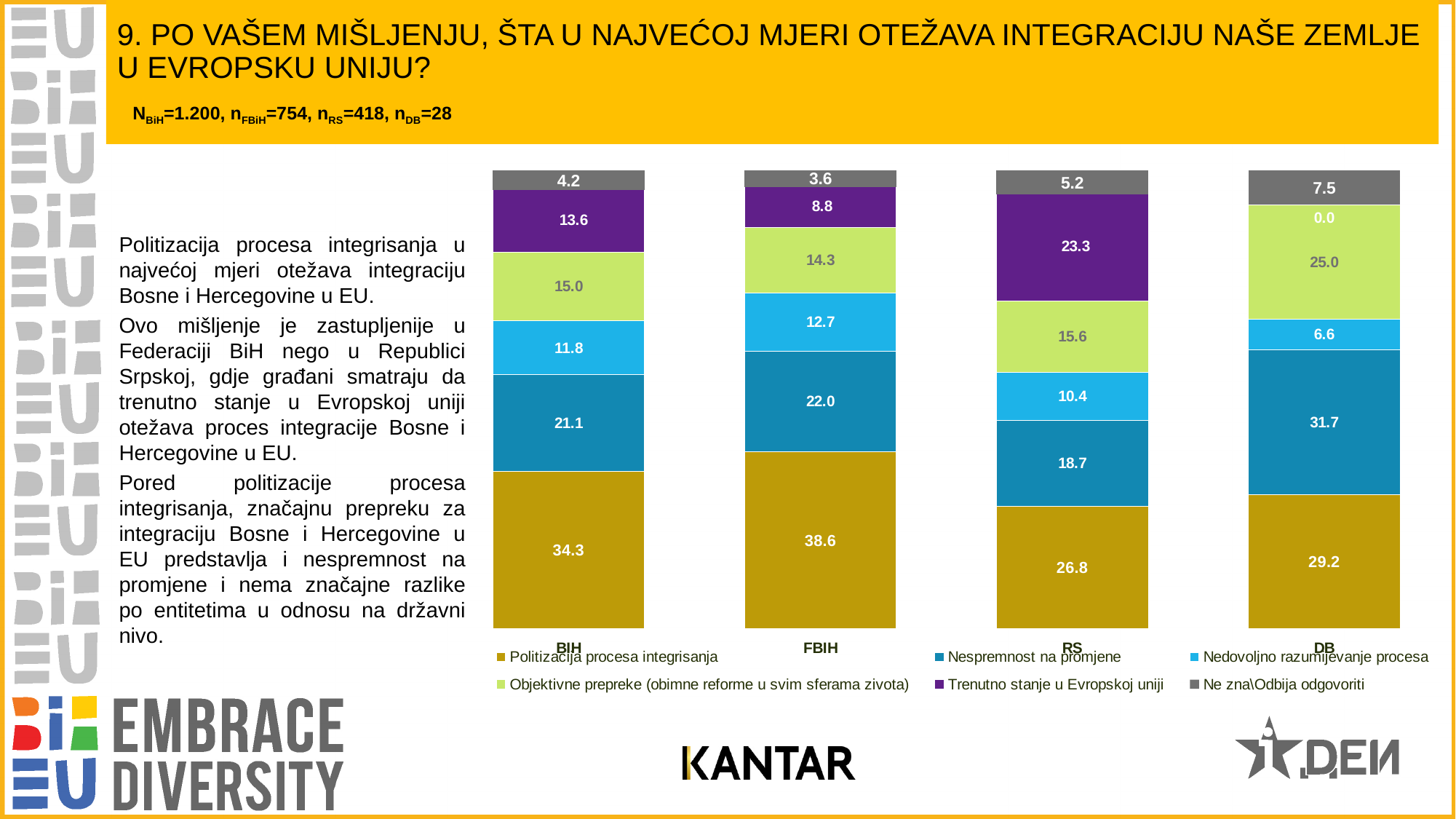
What is the difference between the 'Politizacija procesa integrisanja' values for FBIH and RS? 11.8 How many series does the chart legend list? 6 How many categories (regions) are shown on the x axis of the chart? 4 What kind of chart is shown on the slide? Stacked bar chart Which is larger: 'Trenutno stanje u Evropskoj uniji' for BIH or for FBIH? BIH Which category has the lowest value for 'Nedovoljno razumijevanje procesa'? DB What is the value of 'Nespremnost na promjene' for DB? 31.7 Which series is shown in purple in the chart? Trenutno stanje u Evropskoj uniji What is the total of the stacked bar for BIH? 100.0 What is the value of 'Trenutno stanje u Evropskoj uniji' for RS? 23.3 Which category has the highest value for 'Politizacija procesa integrisanja'? FBIH What is the value of 'Politizacija procesa integrisanja' for FBIH? 38.6